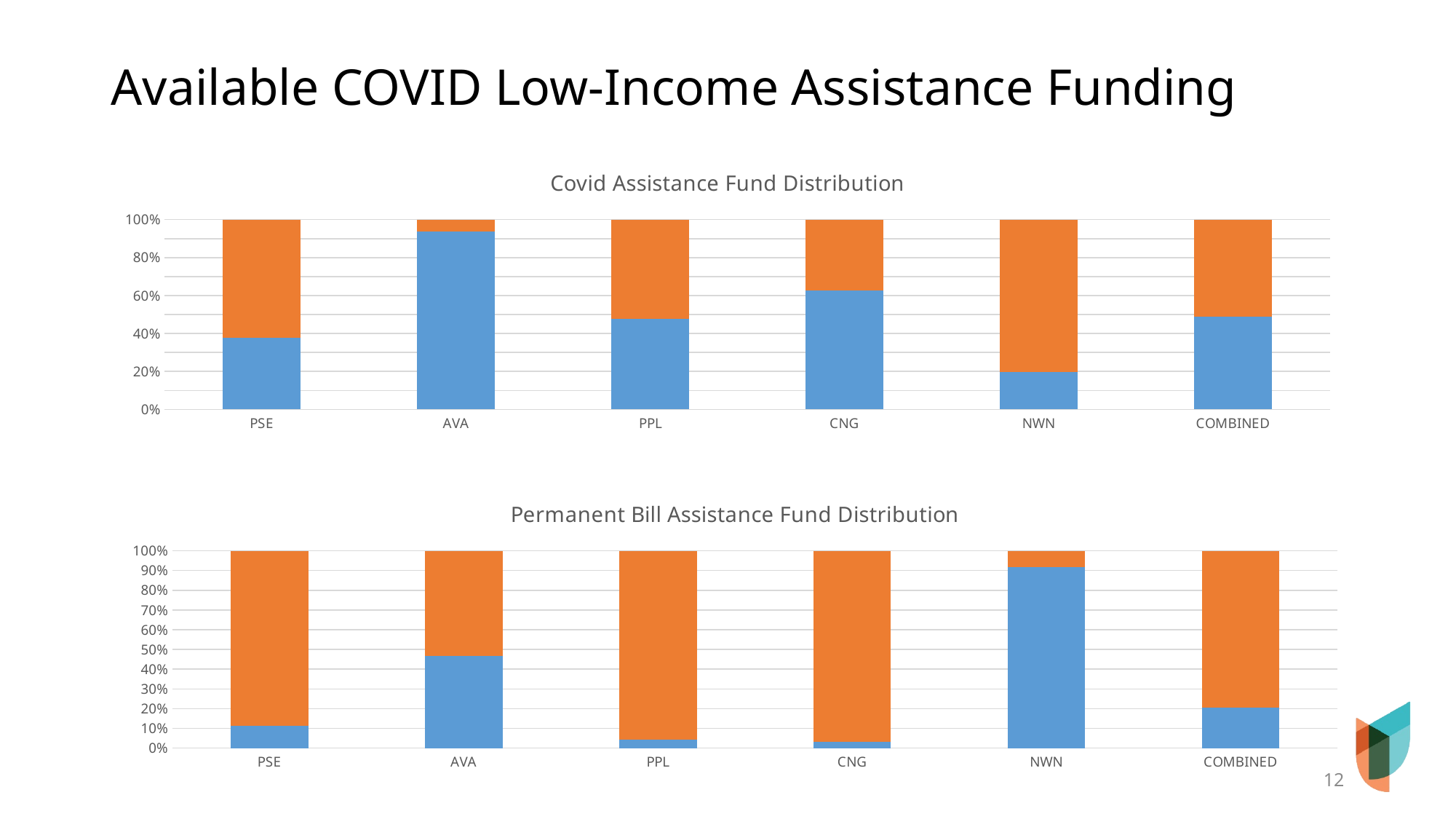
In the bottom chart, 'Permanent Bill Assistance Fund Distribution', is the blue segment for AVA greater or less than 50%? less What is the title of the bottom chart on the slide? Permanent Bill Assistance Fund Distribution In the bottom chart, 'Permanent Bill Assistance Fund Distribution', which category has the largest blue segment? NWN What kind of chart is the top chart, 'Covid Assistance Fund Distribution'? Stacked bar chart In the bottom chart, 'Permanent Bill Assistance Fund Distribution', is the blue segment for NWN greater or less than 80%? greater In the top chart, 'Covid Assistance Fund Distribution', is the blue segment for PSE greater or less than 40%? less In the top chart, 'Covid Assistance Fund Distribution', which category has the largest blue segment? AVA In the bottom chart, 'Permanent Bill Assistance Fund Distribution', is the blue segment larger for AVA or for PSE? AVA In the top chart, 'Covid Assistance Fund Distribution', what value does each stacked bar total? 100% In the top chart, 'Covid Assistance Fund Distribution', how many categories are shown on the x axis? 6 In the top chart, 'Covid Assistance Fund Distribution', which category has the smallest blue segment? NWN